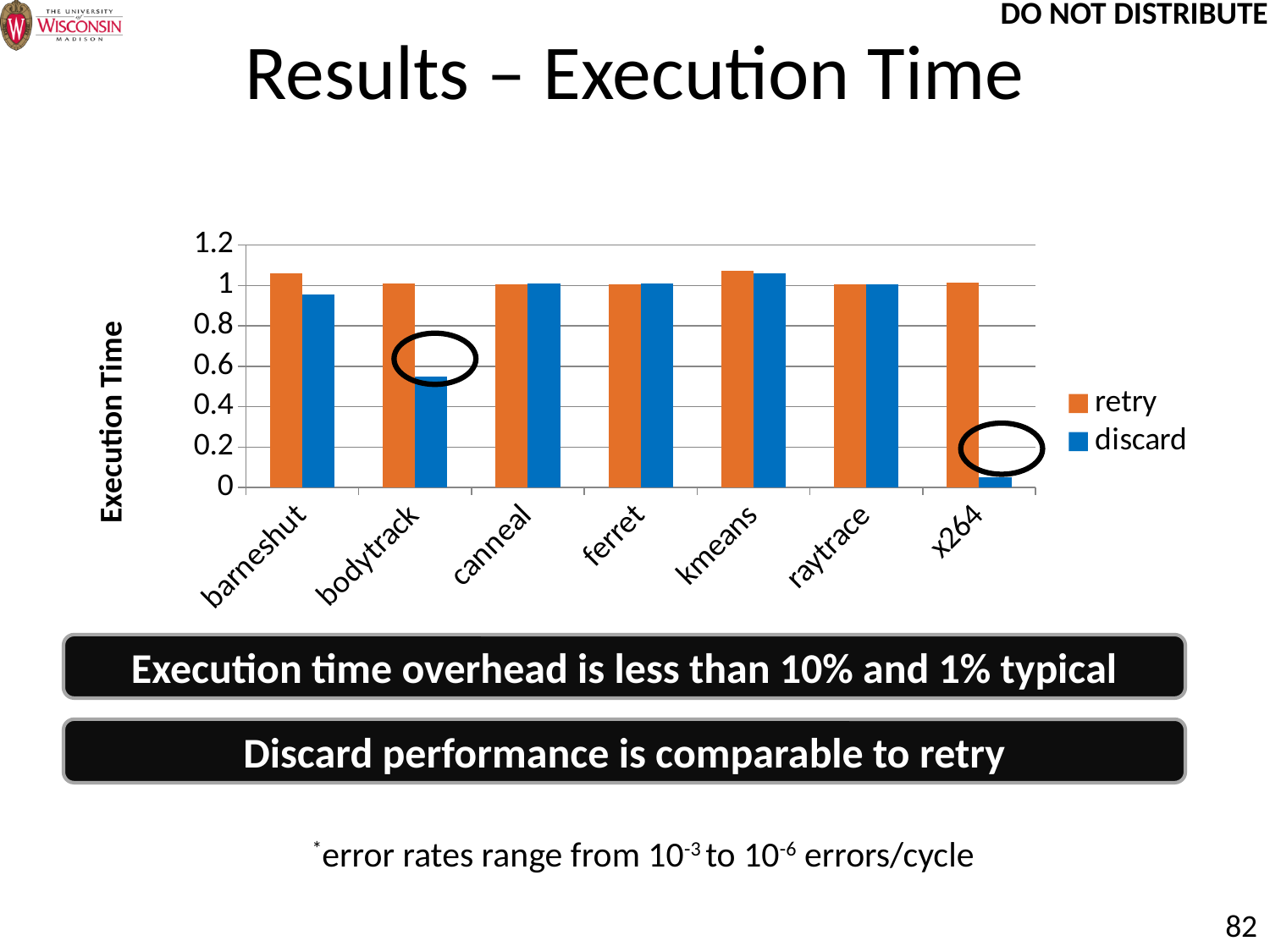
What is the label of the vertical axis? Execution Time Is the discard value for bodytrack greater or less than 0.4? greater For x264, which is larger, the retry value or the discard value? retry Is the discard value for x264 greater or less than 0.2? less Is the retry value for barneshut greater or less than 0.8? greater For bodytrack, which is larger, the retry value or the discard value? retry How many benchmark categories are shown on the x axis? 7 Which colour represents the discard series in the legend? blue How many series does the legend list? 2 Which category has the lowest discard value? x264 What kind of chart is shown on the slide? bar chart